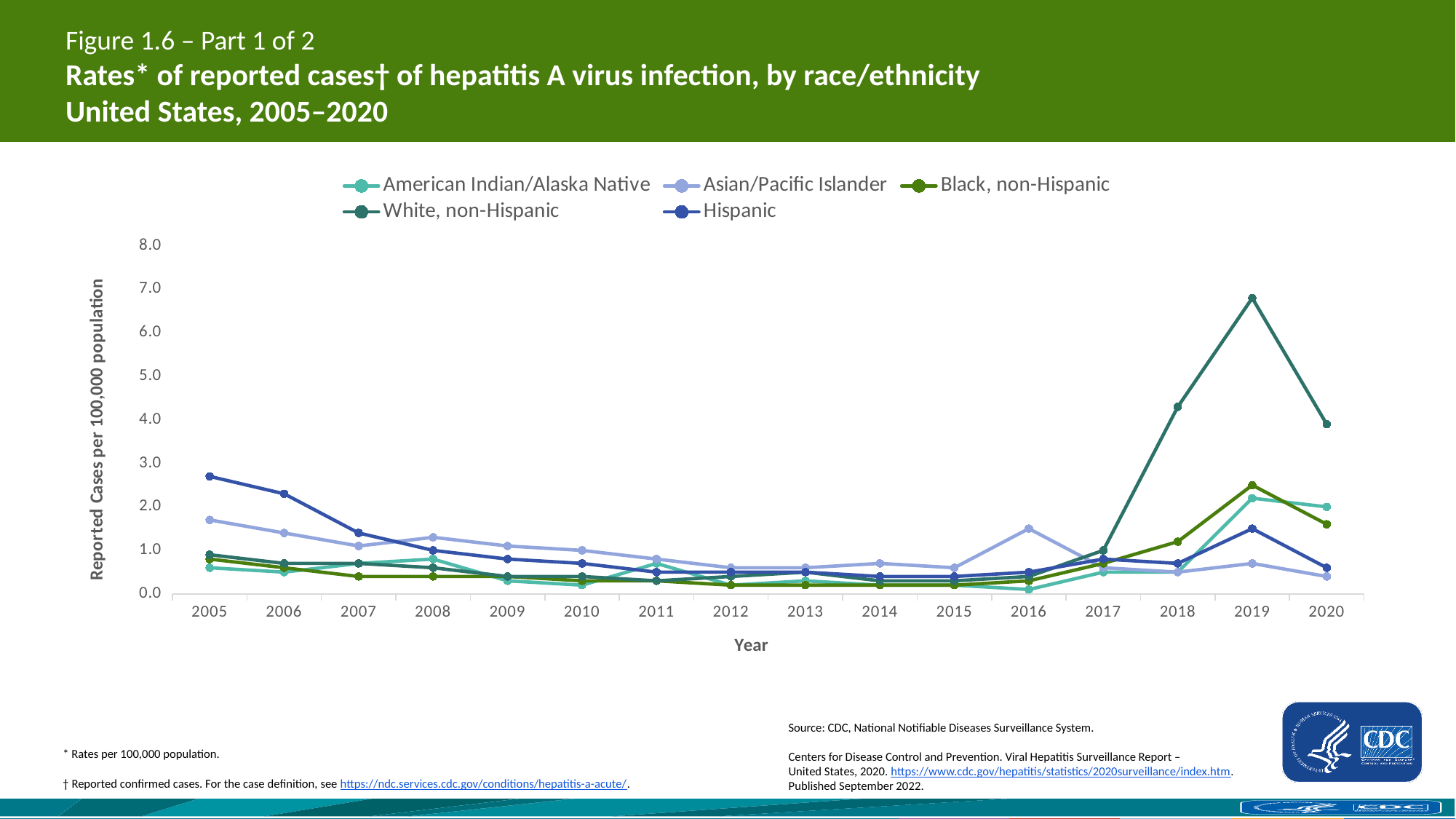
Is the rate for American Indian/Alaska Native in 2016 greater or less than 1.0? less Does the Hispanic rate rise or fall from 2005 to 2007? fall How many years are plotted along the x axis? 16 What kind of chart is shown on the slide? line chart In which year does the White, non-Hispanic series reach its highest rate? 2019 Is the rate for White, non-Hispanic in 2018 greater or less than 4.0? greater Which race/ethnicity group has the highest rate in 2005? Hispanic Which race/ethnicity group has the highest rate in 2019? White, non-Hispanic How many race/ethnicity series does the legend list? 5 Is the rate for Asian/Pacific Islander in 2016 greater or less than 1.0? greater In 2019, which is larger: the rate for White, non-Hispanic or the rate for Black, non-Hispanic? White, non-Hispanic